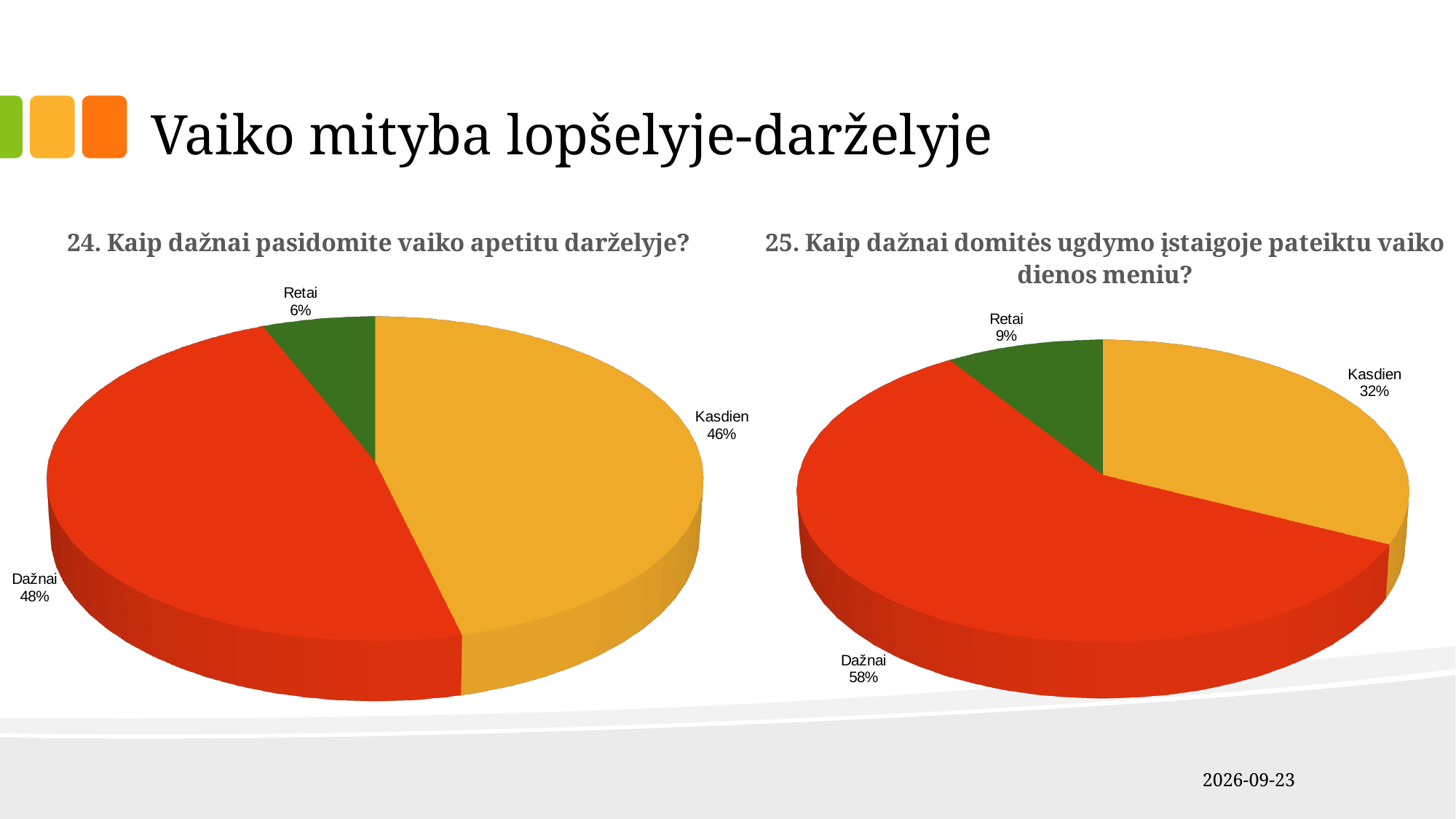
In the left chart (question 24), what colour is the Retai slice? Green In the left chart (question 24), what share of respondents answered Kasdien? 46% In the right chart (question 25), what share of respondents answered Kasdien? 32% In the right chart (question 25), what share of respondents answered Dažnai? 58% In the right chart (question 25), what is the difference in percentage points between Dažnai and Kasdien? 26 In the right chart (question 25), which answer has the smallest share? Retai How many slices does the right chart (question 25) have? 3 In the left chart (question 24), what share of respondents answered Retai? 6% What type of chart is used for question 24 on the left? Pie chart In the left chart (question 24), which answer has the largest share? Dažnai Which is larger: the Retai share in the left chart (question 24) or the Retai share in the right chart (question 25)? Right chart (question 25) In the left chart (question 24), what is the difference in percentage points between Dažnai and Retai? 42